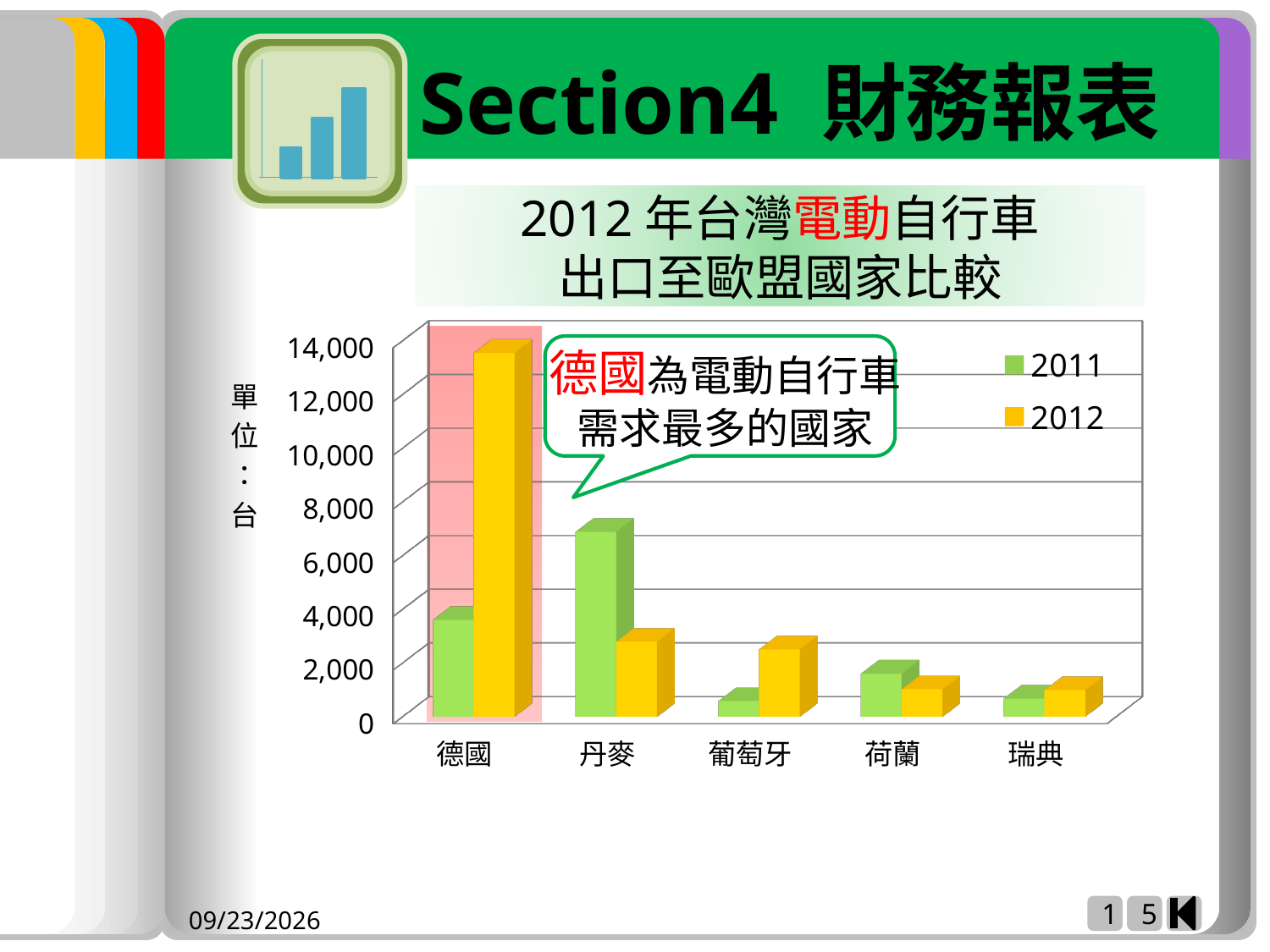
How many series does the chart legend list? 2 Which country has the highest value for 2012? 德國 Is the 2012 value for 德國 greater or less than 12,000? greater For 德國, which year has the larger value, 2011 or 2012? 2012 Which colour represents the 2012 series in the chart? yellow What unit is given for the chart's vertical axis? 台 For 丹麥, which year has the larger value, 2011 or 2012? 2011 Is the 2011 value for 丹麥 greater or less than 8,000? less Is the 2011 value for 葡萄牙 greater or less than 2,000? less What kind of chart is shown on the slide? bar chart Which country has the highest value for 2011? 丹麥 How many countries are shown on the x axis of the chart? 5